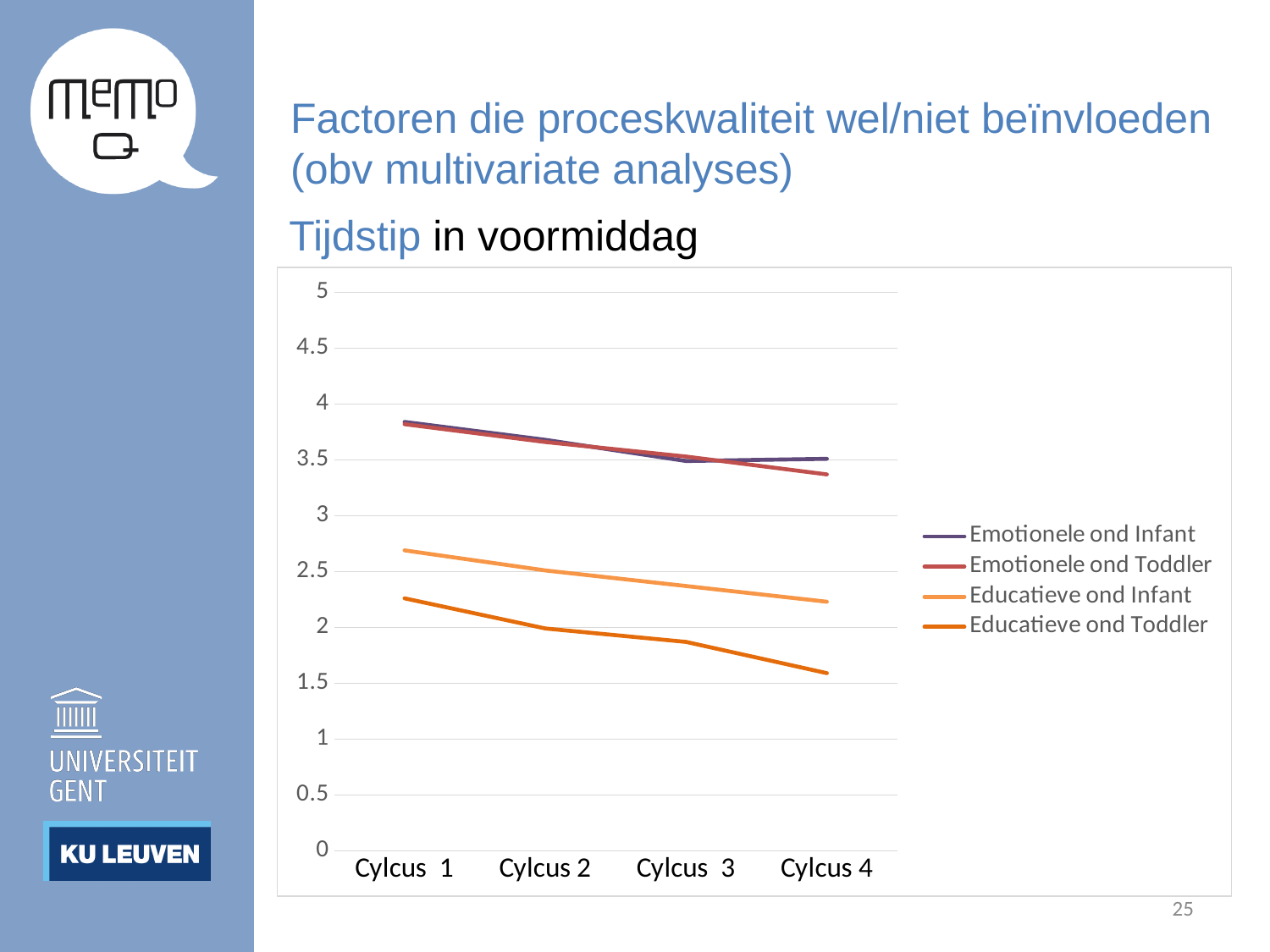
At which category does Educatieve ond Infant reach its lowest value? Cylcus 4 Is the value for Educatieve ond Toddler at Cylcus 1 greater or less than 2? greater How many series does the legend list? 4 Which series has the lowest value at Cylcus 4? Educatieve ond Toddler What kind of chart is shown on the slide? line chart Is the value for Educatieve ond Toddler at Cylcus 4 greater or less than 2? less At Cylcus 4, which is larger: Educatieve ond Infant or Educatieve ond Toddler? Educatieve ond Infant How many categories are shown on the x axis? 4 Is the value for Emotionele ond Infant at Cylcus 1 greater or less than 4? less Do the values for Educatieve ond Toddler rise or fall from Cylcus 1 to Cylcus 4? fall Which series is listed last in the legend? Educatieve ond Toddler